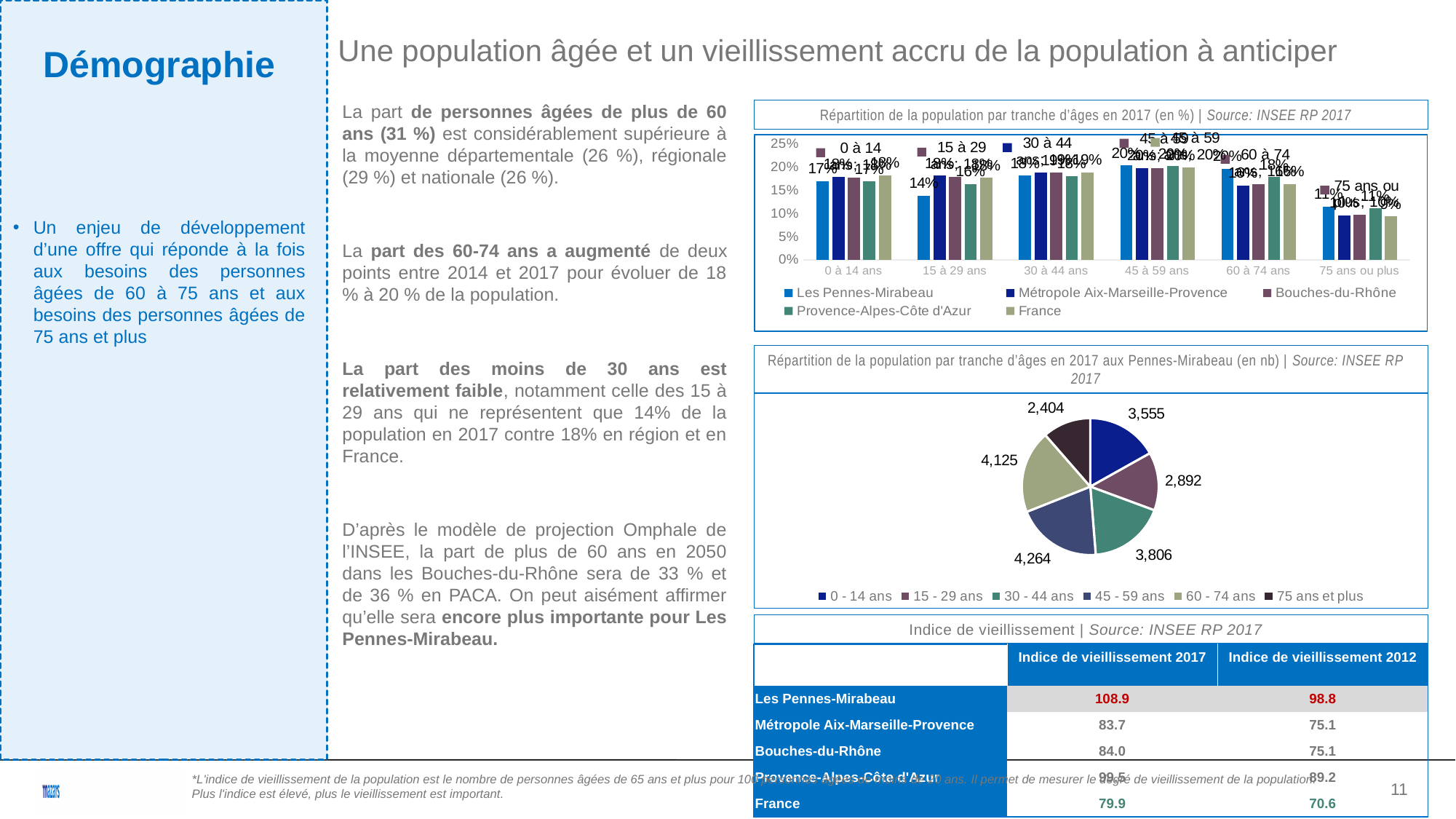
What kind of chart is the middle chart, 'Répartition de la population par tranche d'âges en 2017 aux Pennes-Mirabeau (en nb)'? pie chart In the pie chart, which is larger: the '0 - 14 ans' slice or the '15 - 29 ans' slice? 0 - 14 ans In the top bar chart, is the value for Les Pennes-Mirabeau in the '75 ans ou plus' category greater or less than 15%? less In the top bar chart, what is the value for Les Pennes-Mirabeau in the '0 à 14 ans' category? 17% In the pie chart, which age group has the largest value? 45 - 59 ans What kind of chart is the top chart, 'Répartition de la population par tranche d'âges en 2017 (en %)'? bar chart In the pie chart, which age group has the smallest value? 75 ans et plus In the top bar chart, how many series does the legend list? 5 In the top bar chart, how many age categories are shown on the x axis? 6 In the pie chart, what is the difference between the '30 - 44 ans' value and the '15 - 29 ans' value? 914 In the top bar chart, what is the value for Les Pennes-Mirabeau in the '15 à 29 ans' category? 14% In the pie chart, what is the value for the '45 - 59 ans' slice? 4,264